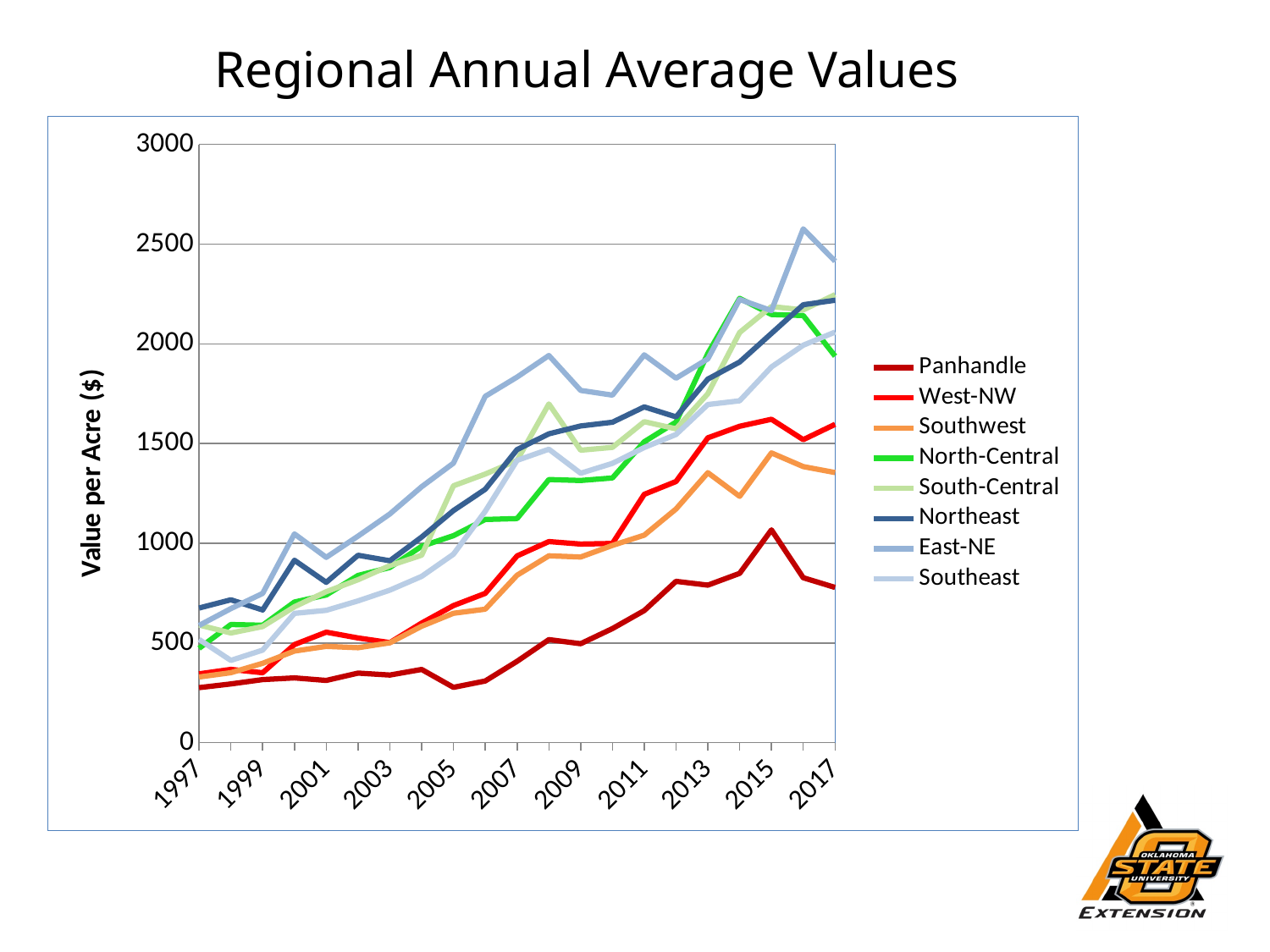
What is the label on the vertical axis? Value per Acre ($) What kind of chart is shown on the slide? line chart In 2015, which is larger, the value for Southwest or the value for Panhandle? Southwest How many series does the legend list? 8 Is the value for East-NE in 2016 greater or less than 2000? greater Is the value for Panhandle in 2017 greater or less than 1000? less Is the value for Southeast in 1999 greater or less than 500? less What is the title of the chart? Regional Annual Average Values Which region has the lowest value in 2017? Panhandle Does the Panhandle series rise or fall overall from 1997 to 2017? rise Which region has the highest value in 2017? East-NE